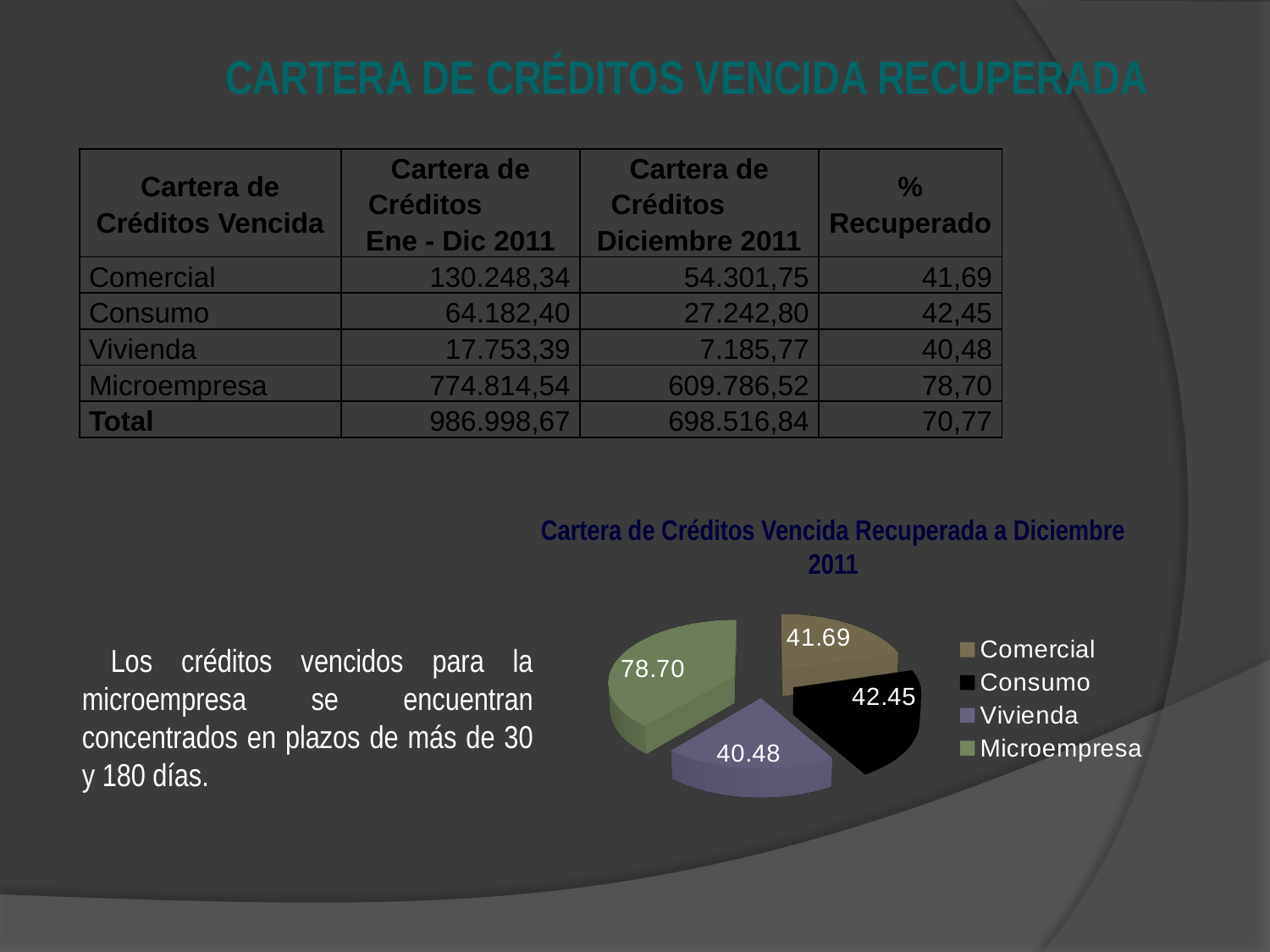
Which category has the largest slice in the pie chart? Microempresa In the pie chart, what is the difference between the values for Microempresa and Consumo? 36.25 What is the title of the pie chart? Cartera de Créditos Vencida Recuperada a Diciembre 2011 In the pie chart, what is the value shown for Comercial? 41.69 In the pie chart, what is the value shown for Vivienda? 40.48 What kind of chart is shown on the slide? pie chart How many categories does the pie chart show? 4 Which category is shown in green in the pie chart? Microempresa In the pie chart, what is the value shown for Microempresa? 78.70 In the pie chart, which is larger, the value for Microempresa or the value for Vivienda? Microempresa Which category has the smallest slice in the pie chart? Vivienda In the pie chart, what is the value shown for Consumo? 42.45